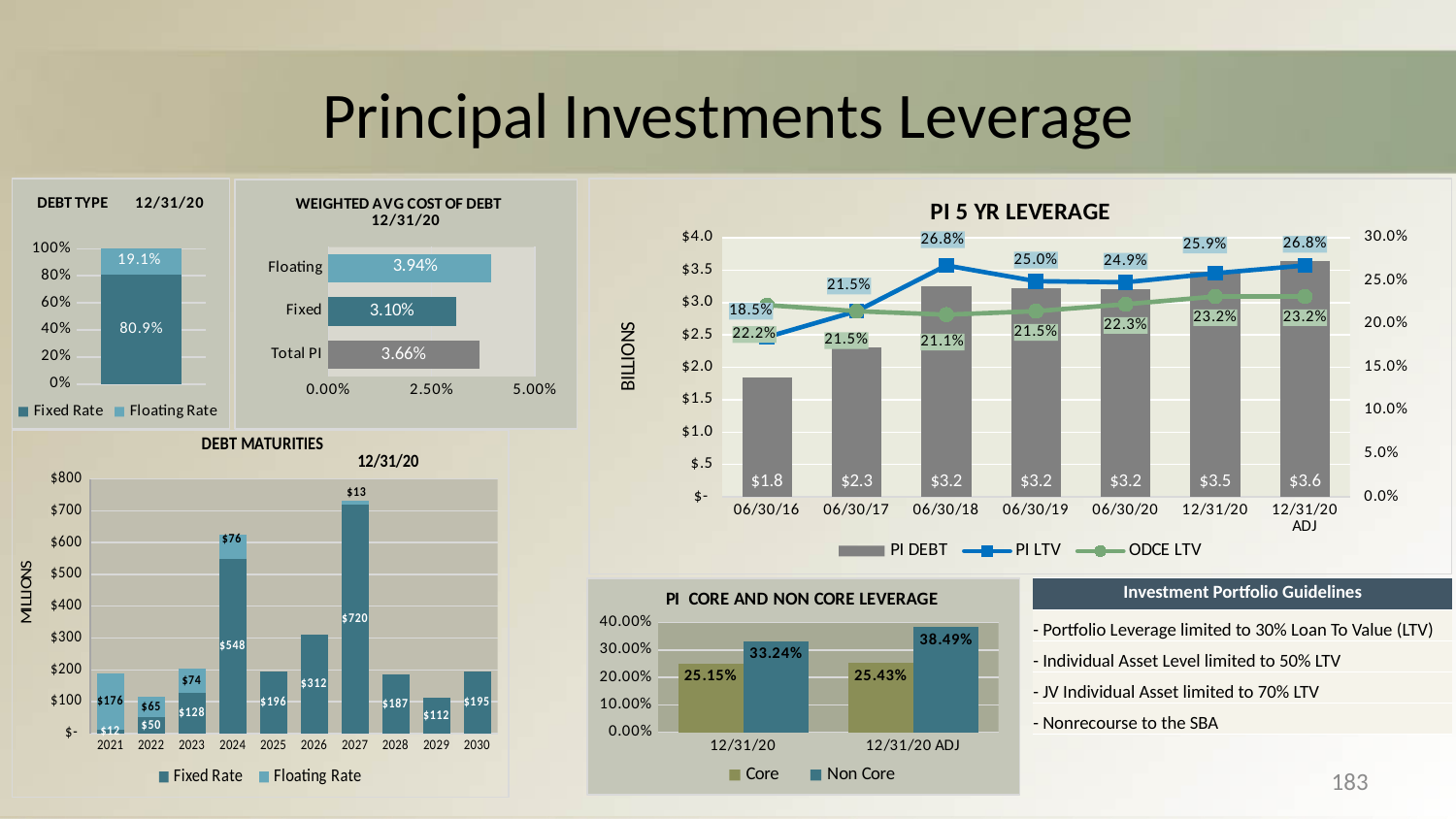
In the PI CORE AND NON CORE LEVERAGE chart, what is the Non Core value for 12/31/20 ADJ? 38.49% In the PI 5 YR LEVERAGE chart, what is the PI DEBT value for 06/30/16? $1.8 In the PI CORE AND NON CORE LEVERAGE chart, what is the difference between the Non Core and Core values for 12/31/20? 8.09% In the WEIGHTED AVG COST OF DEBT chart, which category has the lowest value? Fixed In the PI 5 YR LEVERAGE chart, which is larger at 06/30/16, PI LTV or ODCE LTV? ODCE LTV In the DEBT MATURITIES chart, what is the Fixed Rate value for 2027? $720 In the DEBT TYPE chart, what share of debt is Fixed Rate? 80.9% In the WEIGHTED AVG COST OF DEBT chart, what is the value for Floating? 3.94% In the WEIGHTED AVG COST OF DEBT chart, what is the difference between the Floating and Fixed values? 0.84% In the PI 5 YR LEVERAGE chart, how many series does the legend list? 3 In the PI 5 YR LEVERAGE chart, what is the PI LTV value for 12/31/20? 25.9% In the DEBT MATURITIES chart, how many years are shown on the x axis? 10